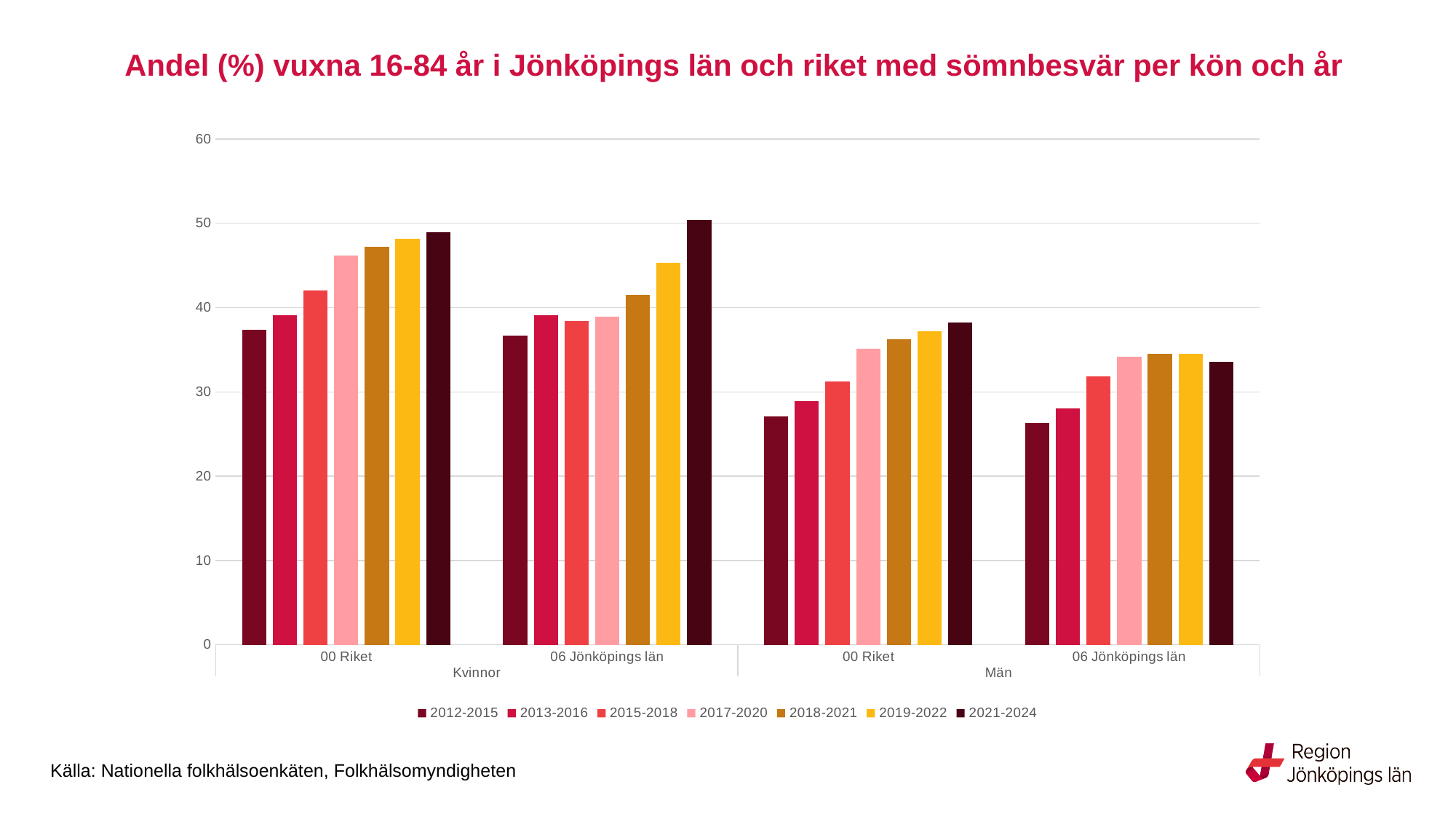
For 2012-2015 in the 00 Riket groups, which is larger: Kvinnor or Män? Kvinnor Is the value for 2021-2024 in the Män 06 Jönköpings län group greater or less than 30? greater How many series does the legend list? 7 Do the values for Kvinnor 00 Riket rise or fall from 2012-2015 to 2021-2024? rise Is the value for 2019-2022 in the Kvinnor 00 Riket group greater or less than 40? greater Which period has the highest value in the Kvinnor 06 Jönköpings län group? 2021-2024 How many category groups of bars are shown along the x axis? 4 What is the title of the chart? Andel (%) vuxna 16-84 år i Jönköpings län och riket med sömnbesvär per kön och år Is the value for 2012-2015 in the Män 00 Riket group greater or less than 30? less For 2021-2024 among Män, which is larger: 00 Riket or 06 Jönköpings län? 00 Riket Which period has the lowest value in the Män 06 Jönköpings län group? 2012-2015 What kind of chart is shown on the slide? Bar chart